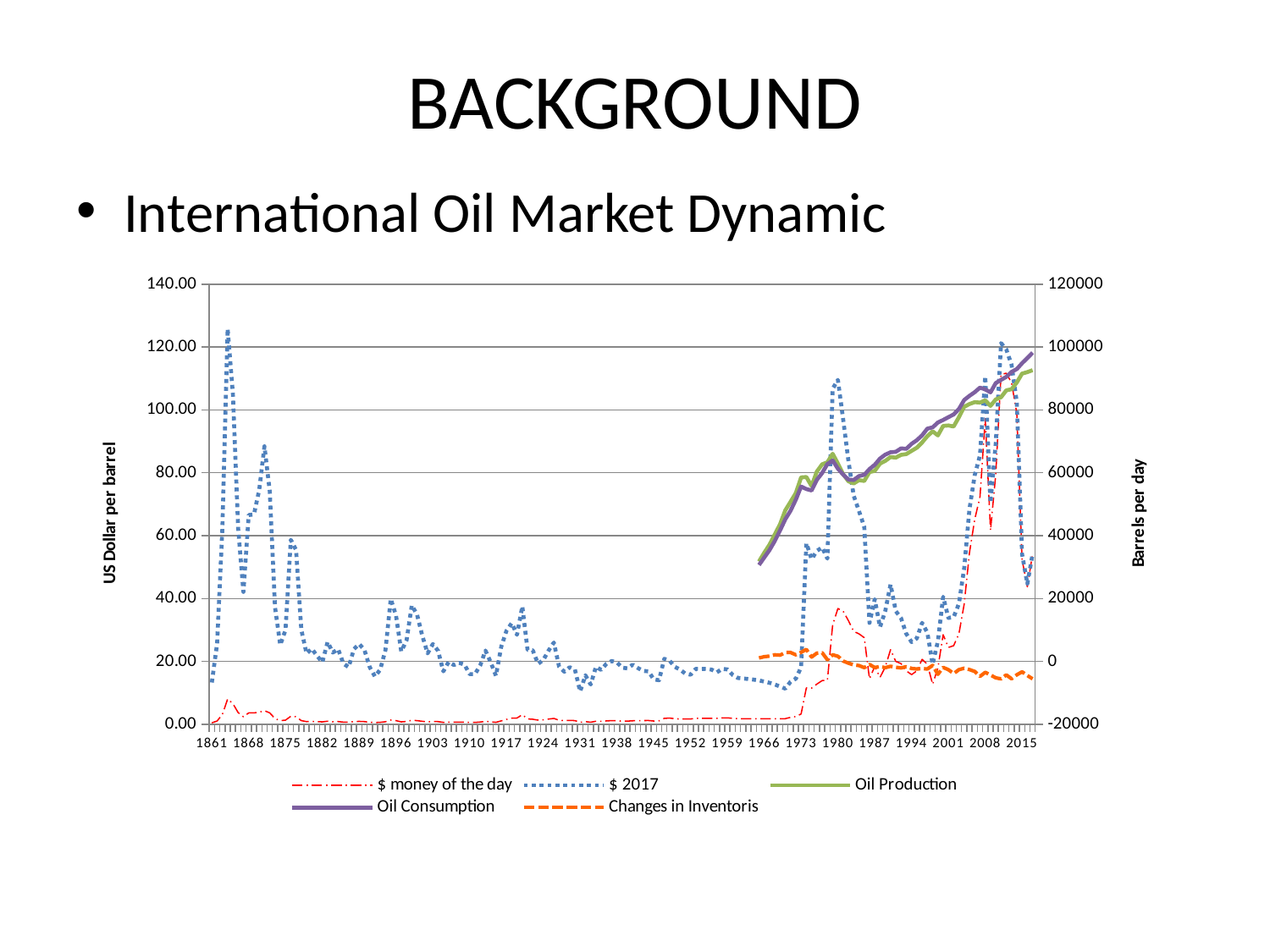
How many year labels are shown on the x axis? 23 Is the value of Oil Production at its start around 1966 greater or less than 40000 barrels per day? less How many series does the legend list? 5 What is the title of the left vertical axis? US Dollar per barrel Is the value of $ money of the day in 1861 greater or less than 20? less In 2015, which is larger, Oil Consumption or Oil Production? Oil Consumption Is the value of Oil Consumption in 2015 greater or less than 80000 barrels per day? greater Does the Oil Consumption series rise or fall overall from 1966 to 2015? rises What is the title of the right vertical axis? Barrels per day What kind of chart is shown on the slide? line chart Which series reaches the highest value on the left axis (US Dollar per barrel)? $ 2017